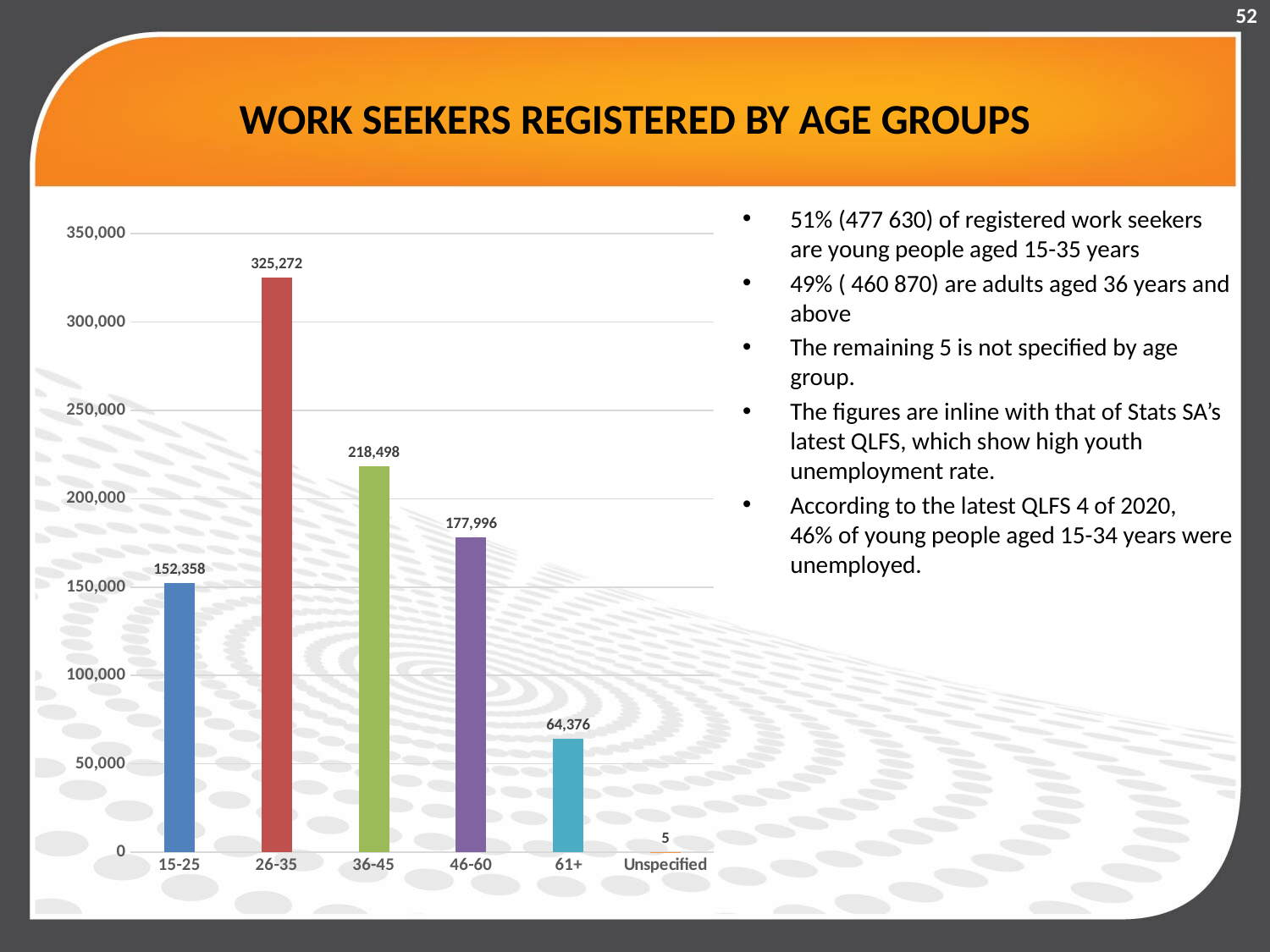
What is the number of registered work seekers in the 26-35 age group? 325,272 What is the value shown for the 15-25 age group? 152,358 From the 26-35 group to the Unspecified category, do the values rise or fall along the x axis? Fall What is the value shown for the 61+ age group? 64,376 Which is larger, the value for 36-45 or the value for 46-60? 36-45 Which category has the lowest value in the chart? Unspecified What is the difference between the values for the 36-45 and 46-60 age groups? 40,502 What is the value shown for the Unspecified category? 5 What is the difference between the values for the 26-35 and 15-25 age groups? 172,914 How many age group categories are shown on the x axis? 6 What kind of chart is shown on the slide? Bar chart Which age group has the highest number of registered work seekers? 26-35